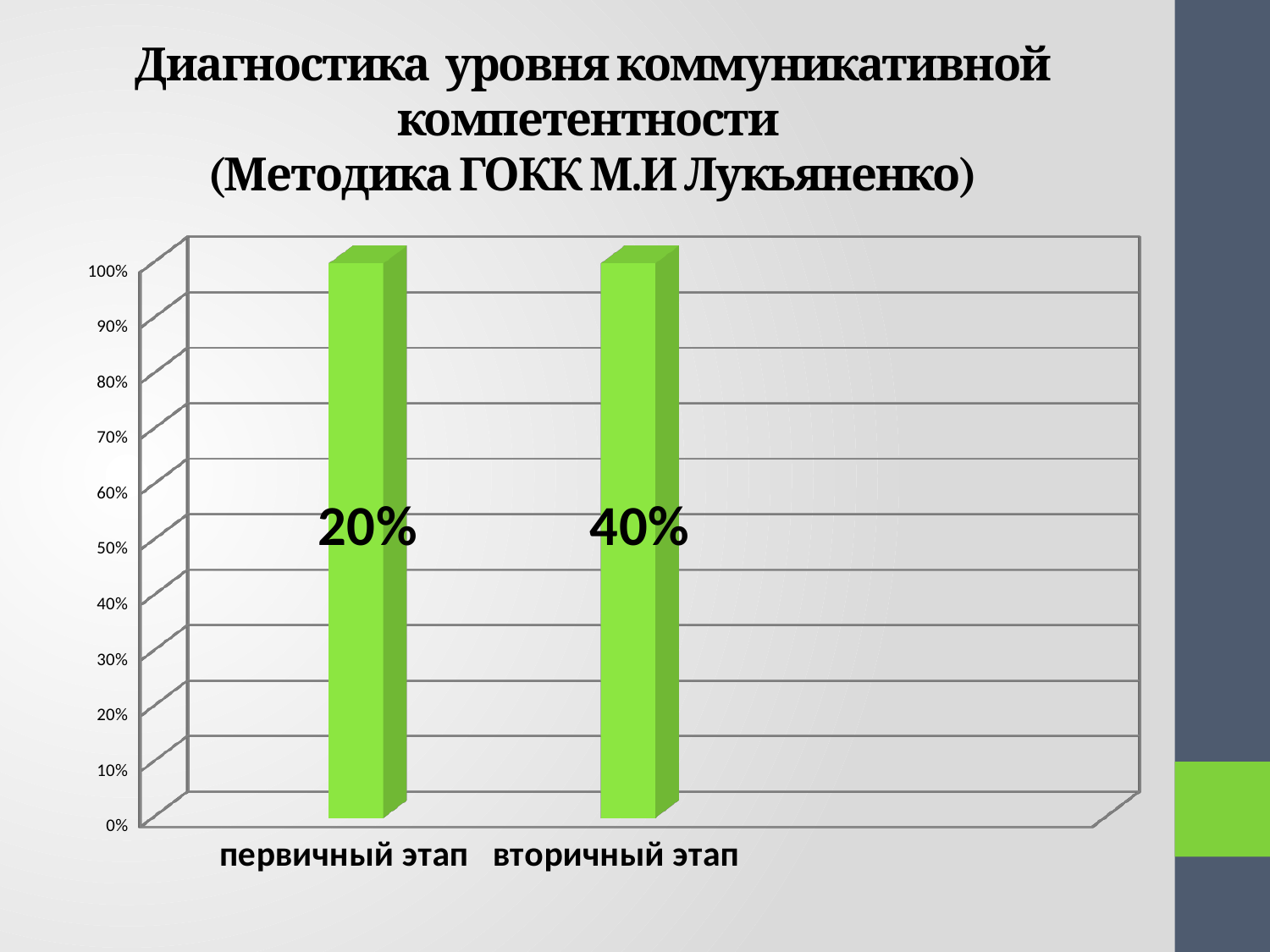
Which category has the lowest labelled value? первичный этап Which category has the highest labelled value? вторичный этап Which stage has the higher labelled value, первичный этап or вторичный этап? вторичный этап What colour are the bars in the chart? green What is the highest tick value shown on the vertical axis? 100% What is the difference between the labelled values for вторичный этап and первичный этап? 20% How many categories are shown on the x axis? 2 What value is labelled on the bar for вторичный этап? 40% What kind of chart is shown on the slide? bar chart What value is labelled on the bar for первичный этап? 20% Do the labelled values rise or fall from первичный этап to вторичный этап? rise